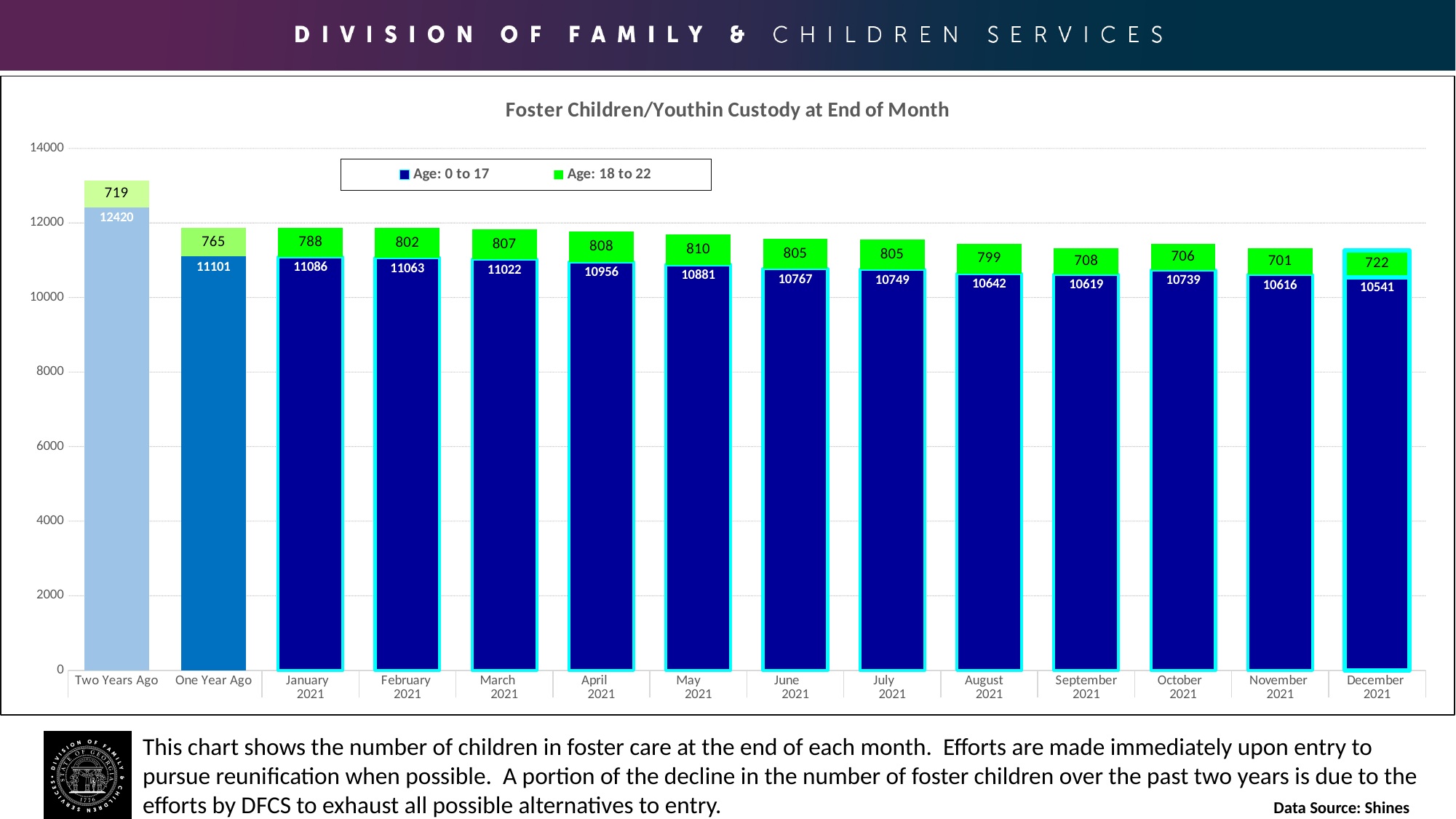
What kind of chart is shown on the slide? Stacked bar chart Which category has the lowest value for Age: 18 to 22? November 2021 How many series does the legend list? 2 Which category has the lowest value for Age: 0 to 17? December 2021 Which is larger for Age: 0 to 17, September 2021 or October 2021? October 2021 What is the total of the stacked bar for December 2021? 11263 What is the value for Age: 18 to 22 in May 2021? 810 Which category has the highest value for Age: 0 to 17? Two Years Ago Is the value for Age: 0 to 17 in June 2021 greater or less than 10000? greater How many categories are shown on the x axis? 14 What is the difference between the Age: 0 to 17 values for Two Years Ago and One Year Ago? 1319 What is the value for Age: 0 to 17 in March 2021? 11022